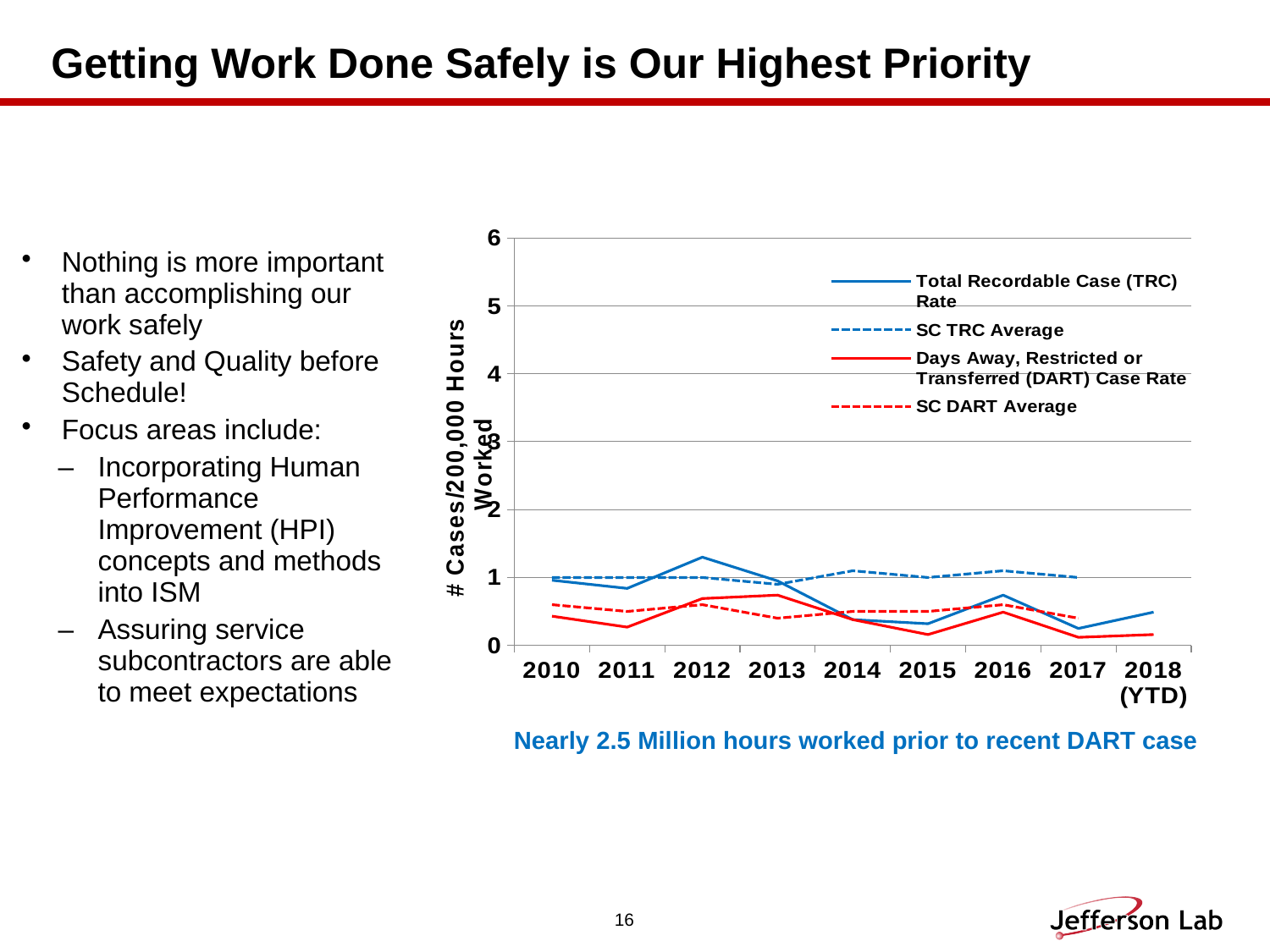
In which year is the Total Recordable Case (TRC) Rate highest? 2012 What kind of chart is shown on the slide? line chart How many series does the chart legend list? 4 Is the Total Recordable Case (TRC) Rate in 2015 greater or less than 1? less How many years are shown along the x axis of the chart? 9 In 2012, which is larger: the Total Recordable Case (TRC) Rate or the Days Away, Restricted or Transferred (DART) Case Rate? Total Recordable Case (TRC) Rate In 2010, which is larger: the Total Recordable Case (TRC) Rate or the Days Away, Restricted or Transferred (DART) Case Rate? Total Recordable Case (TRC) Rate What is the label of the last category on the x axis of the chart? 2018 (YTD) Is the Days Away, Restricted or Transferred (DART) Case Rate in 2017 greater or less than 1? less What is the label on the y axis of the chart? # Cases/200,000 Hours Worked Is the Total Recordable Case (TRC) Rate in 2012 greater or less than 1? greater